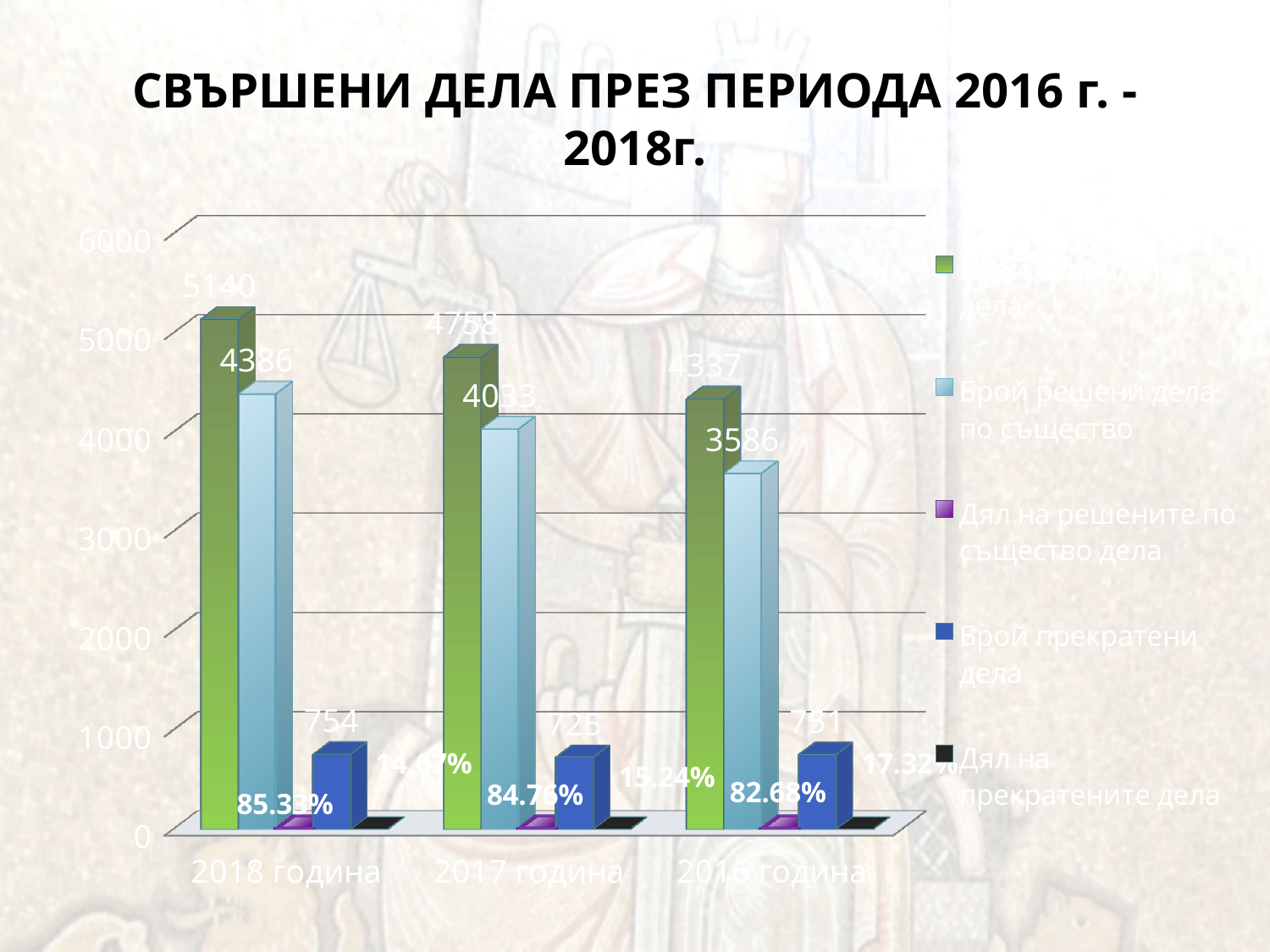
How many series does the legend list? 5 What is the 'Дял на прекратените дела' value for 2016 година? 17.32% Which year has the lowest value for 'Брой решени дела по същество'? 2016 година Is the 'Брой решени дела по същество' value for 2016 година greater or less than 4000? less What is the value of the 'Брой решени дела по същество' series for 2018 година? 4386 How many year categories are shown on the x axis? 3 What is the value of the 'Брой прекратени дела' series for 2017 година? 725 What is the 'Дял на решените по същество дела' value for 2017 година? 84.76% What kind of chart is shown on the slide? bar chart What is the difference between the 'Брой решени дела по същество' values for 2018 година and 2017 година? 353 What is the value of the tallest green bar, and which year does it belong to? 5140, 2018 година Which is larger: 'Брой прекратени дела' for 2018 година or for 2016 година? 2018 година